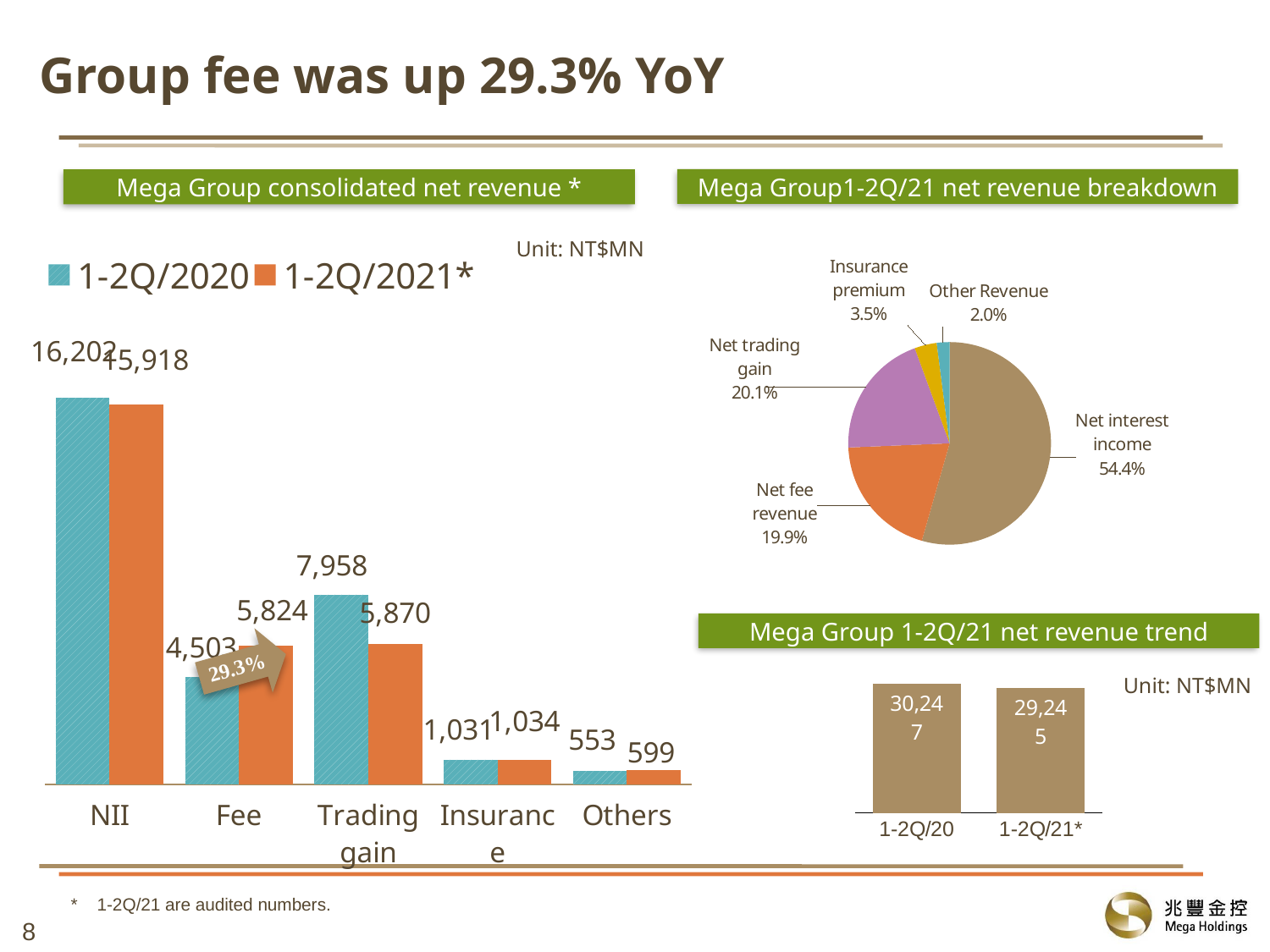
In the 'Mega Group consolidated net revenue' chart, which category has the highest value for 1-2Q/2021*? NII In the 'Mega Group consolidated net revenue' chart, what is the difference between the Fee values for 1-2Q/2021* and 1-2Q/2020? 1,321 How many series does the legend of the 'Mega Group consolidated net revenue' chart list? 2 In the 'Mega Group consolidated net revenue' chart, what is the Fee value for 1-2Q/2021*? 5,824 In the 'Mega Group1-2Q/21 net revenue breakdown' pie chart, what share does Net trading gain have? 20.1% In the 'Mega Group 1-2Q/21 net revenue trend' chart, what is the value for 1-2Q/21*? 29,245 In the 'Mega Group consolidated net revenue' chart, which category has the lowest value for 1-2Q/2020? Others How many categories are shown on the x axis of the 'Mega Group consolidated net revenue' chart? 5 What kind of chart is the 'Mega Group1-2Q/21 net revenue breakdown' chart? Pie chart In the 'Mega Group consolidated net revenue' chart, which is larger for Trading gain: 1-2Q/2020 or 1-2Q/2021*? 1-2Q/2020 In the 'Mega Group1-2Q/21 net revenue breakdown' pie chart, which slice is the largest? Net interest income In the 'Mega Group consolidated net revenue' chart, what is the Trading gain value for 1-2Q/2020? 7,958